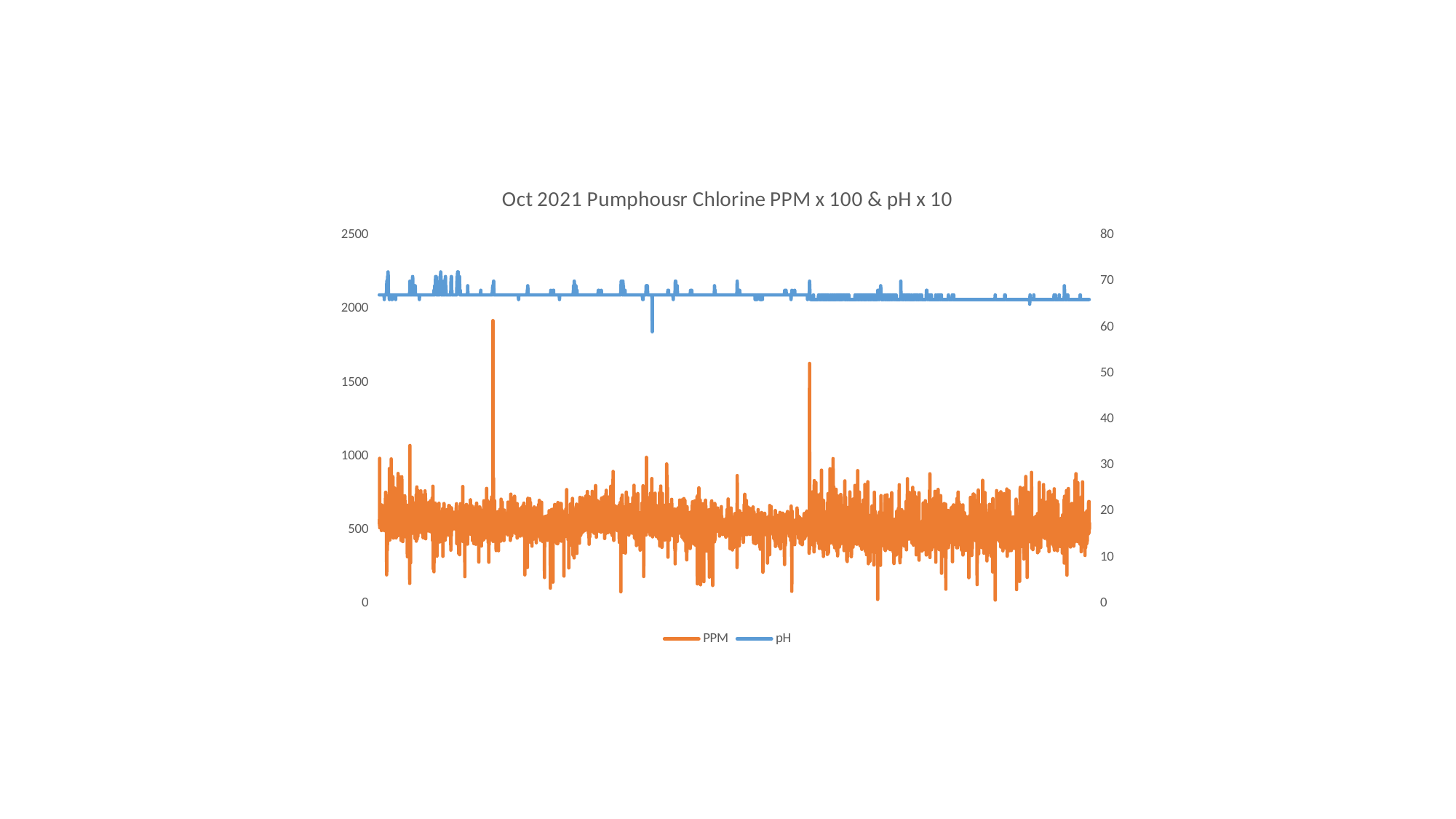
What is the maximum tick value shown on the left vertical axis? 2500 Is the highest value of the PPM series greater or less than 2000 on the left axis? less Is the lowest value of the pH series greater or less than 50 on the right axis? greater Is the lowest value of the pH series greater or less than 70 on the right axis? less What kind of chart is shown on the slide? Line chart Which series is drawn in orange? PPM How many series does the legend list? 2 What is the maximum tick value shown on the right vertical axis? 80 What is the title of the chart? Oct 2021 Pumphousr Chlorine PPM x 100 & pH x 10